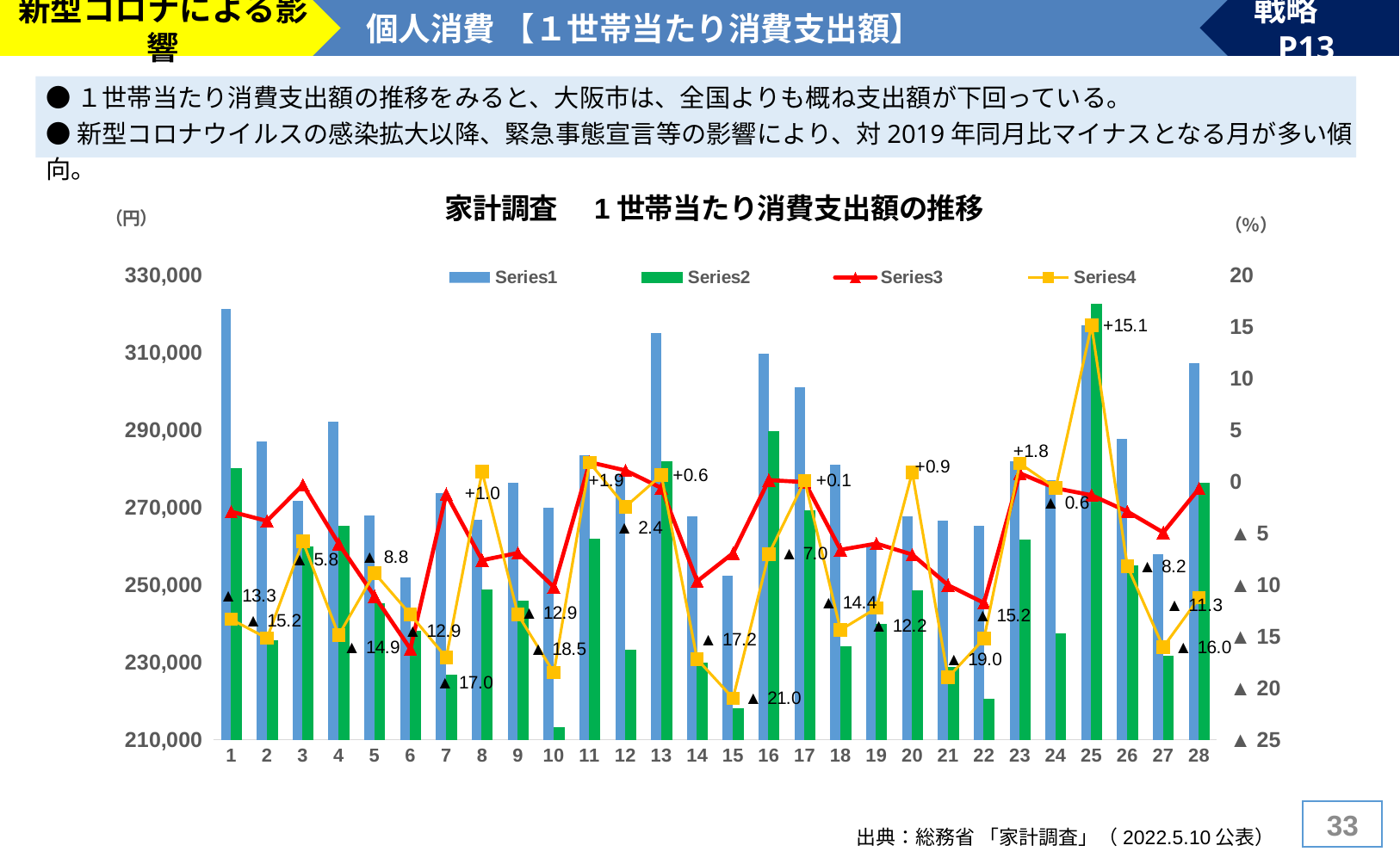
What is the Series4 value at category 8? +1.0 At which category is the Series2 bar the tallest? 25 Is the Series2 value at category 10 greater or less than 230,000? less At which category does Series4 reach its highest value? 25 What is the Series4 value at category 25? +15.1 How many series does the legend list? 4 At which category is the Series2 bar the shortest? 10 What is the Series4 value at category 15? ▲21.0 How many categories are shown on the x axis? 28 At which category does Series4 reach its lowest value? 15 By how many percentage points does the Series4 value at category 3 (▲5.8) differ from the value at category 2 (▲15.2)? 9.4 At category 1, which is larger, the Series1 bar or the Series2 bar? Series1